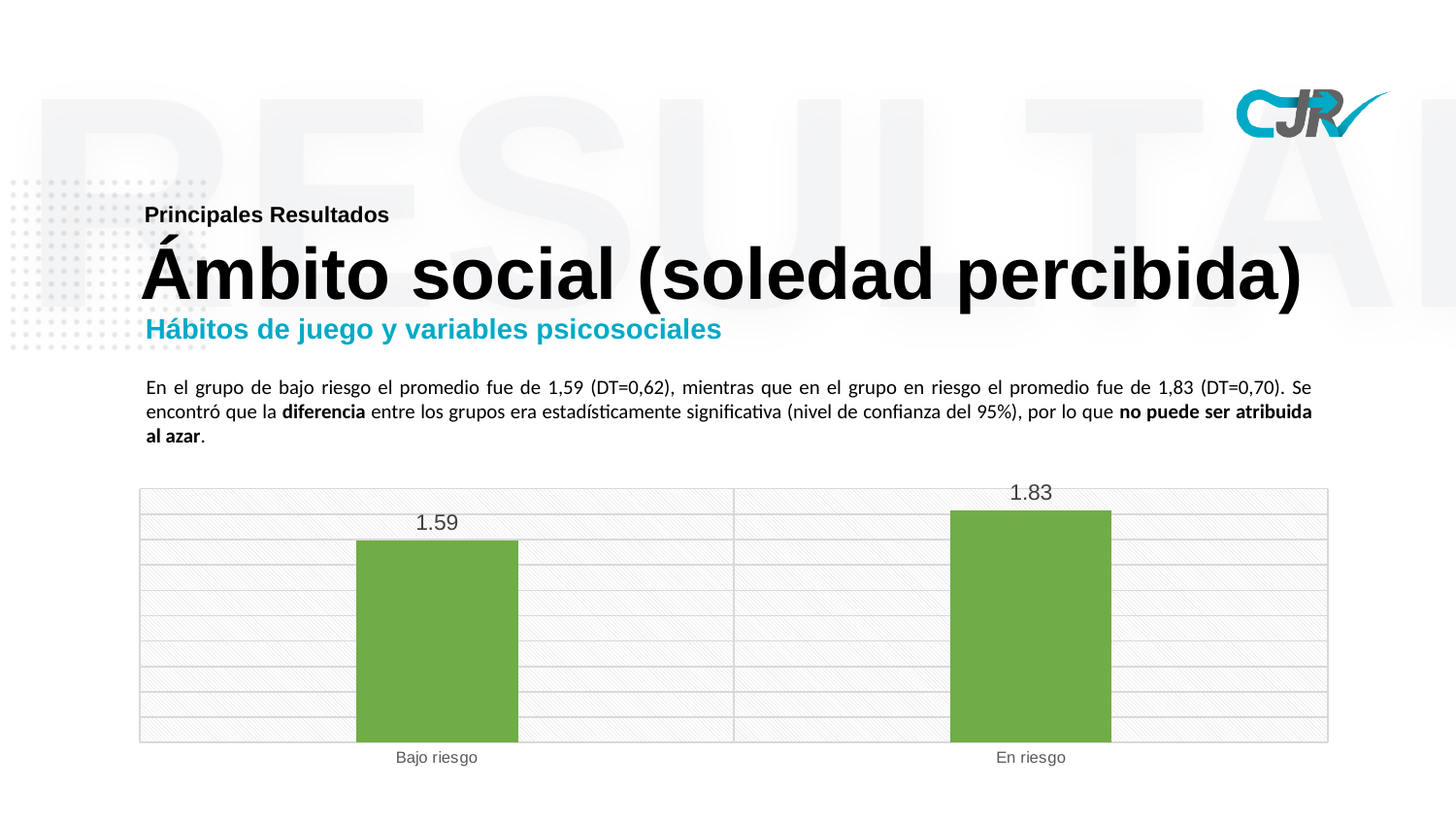
What colour are the bars in the chart? Green What is the value for Bajo riesgo? 1.59 Which category has the highest value? En riesgo How many categories are shown in the chart? 2 What is the difference between the values for En riesgo and Bajo riesgo? 0.24 What is the value for En riesgo? 1.83 What kind of chart is shown on the slide? Bar chart Which category has the lowest value? Bajo riesgo Which is larger, the value for Bajo riesgo or the value for En riesgo? En riesgo What is the label of the first category on the x axis? Bajo riesgo Do the values rise or fall from Bajo riesgo to En riesgo? Rise